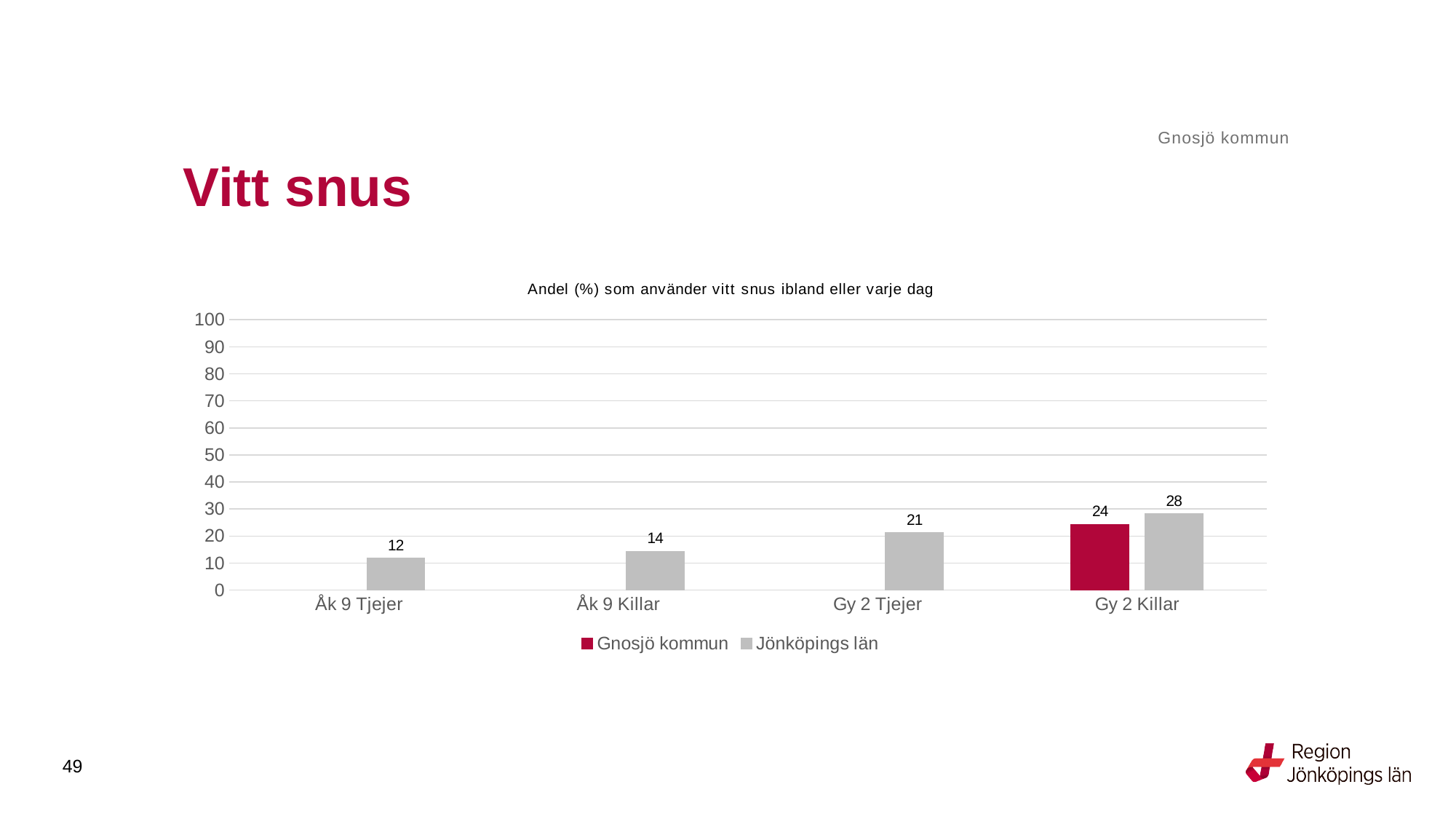
Which category has the lowest Jönköpings län value? Åk 9 Tjejer What is the difference between the Jönköpings län and Gnosjö kommun values for Gy 2 Killar? 4 What is the value for Jönköpings län for Gy 2 Killar? 28 What is the value for Jönköpings län for Åk 9 Tjejer? 12 What is the value for Gnosjö kommun for Gy 2 Killar? 24 Which category has the highest Jönköpings län value? Gy 2 Killar What kind of chart is shown? bar chart How many categories are shown on the x axis? 4 Is the Jönköpings län value for Åk 9 Killar greater or less than 20? less How many series does the legend list? 2 For Gy 2 Killar, which is larger: Gnosjö kommun or Jönköpings län? Jönköpings län What is the value for Jönköpings län for Gy 2 Tjejer? 21